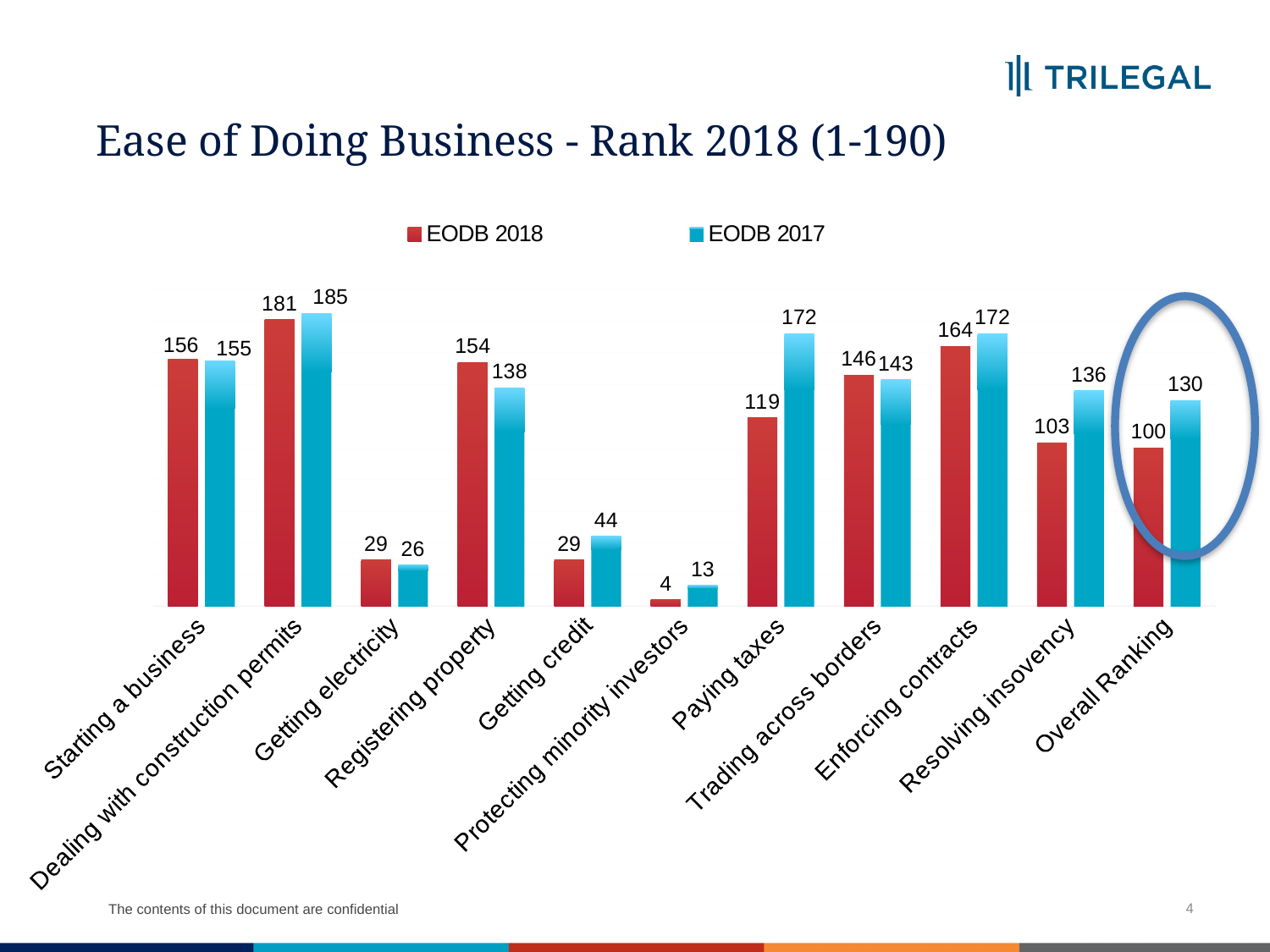
What is the EODB 2018 value for Overall Ranking? 100 What kind of chart is shown on the slide? Bar chart What is the EODB 2017 value for Dealing with construction permits? 185 Which category has the lowest EODB 2017 value? Protecting minority investors What is the EODB 2018 value for Paying taxes? 119 Which category is highlighted with a circle on the chart? Overall Ranking For Registering property, which is larger: the EODB 2018 value or the EODB 2017 value? EODB 2018 What is the difference between the EODB 2017 and EODB 2018 values for Overall Ranking? 30 Which category has the highest EODB 2018 value? Dealing with construction permits How many categories are shown on the x axis? 11 How many series does the legend list? 2 What is the difference between the EODB 2017 and EODB 2018 values for Paying taxes? 53